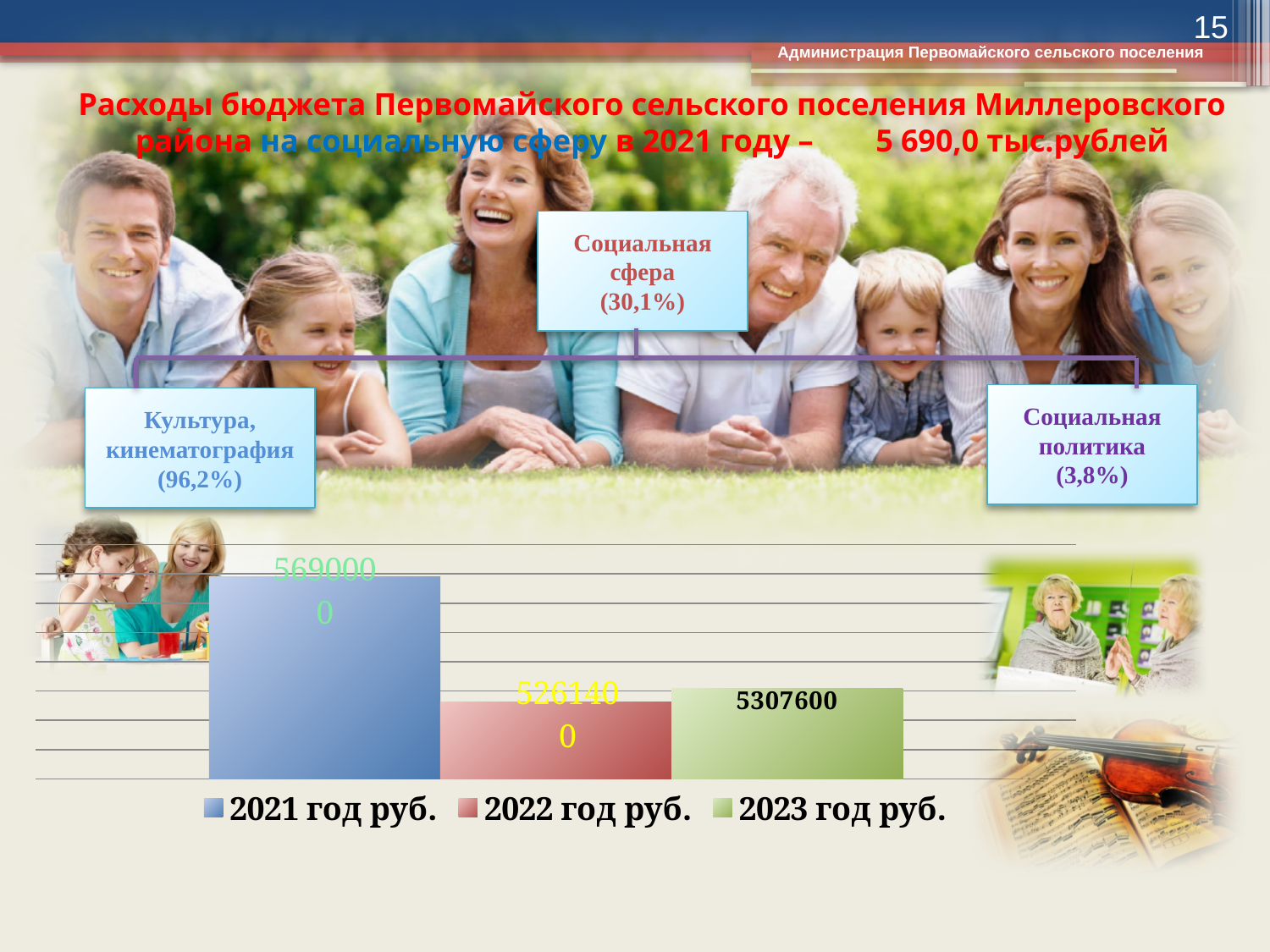
Which year has the highest value in the bar chart? 2021 год руб. What kind of chart is shown on the slide? bar chart What is the difference between the 2021 and 2022 values in the bar chart? 428600 What is the value for 2022 год руб. in the bar chart? 5261400 What is the value for 2023 год руб. in the bar chart? 5307600 What is the value for 2021 год руб. in the bar chart? 5690000 Does the value rise or fall from 2021 to 2022 in the bar chart? fall Which year has the lowest value in the bar chart? 2022 год руб. Which is larger in the bar chart, the value for 2021 or the value for 2023? 2021 How many series does the legend of the bar chart list? 3 What colour is the bar for 2022 год руб. in the chart? red What is the difference between the 2023 and 2022 values in the bar chart? 46200